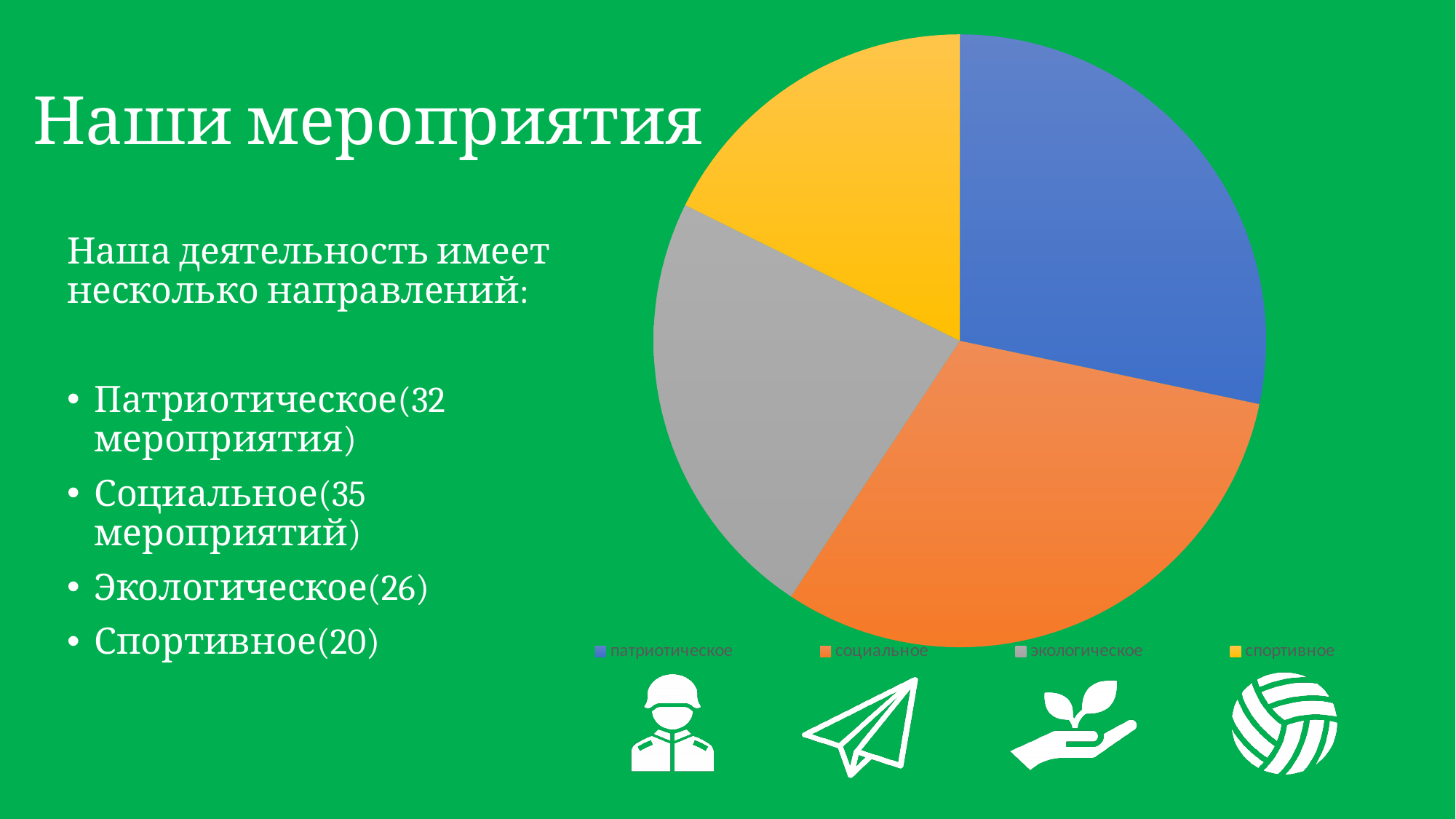
What is the title of the slide containing the pie chart? Наши мероприятия How many events does the 'спортивное' category have? 20 Which category has the largest slice of the pie chart? социальное How many slices does the pie chart have? 4 What kind of chart is shown on the slide? pie chart How many events does the 'социальное' category have? 35 How many events does the 'патриотическое' category have? 32 What is the difference between the number of 'социальное' events and 'спортивное' events? 15 How many entries does the legend of the pie chart list? 4 Which category has more events, 'экологическое' or 'спортивное'? экологическое Which category has the smallest slice of the pie chart? спортивное Which colour represents the category 'экологическое' in the pie chart? grey